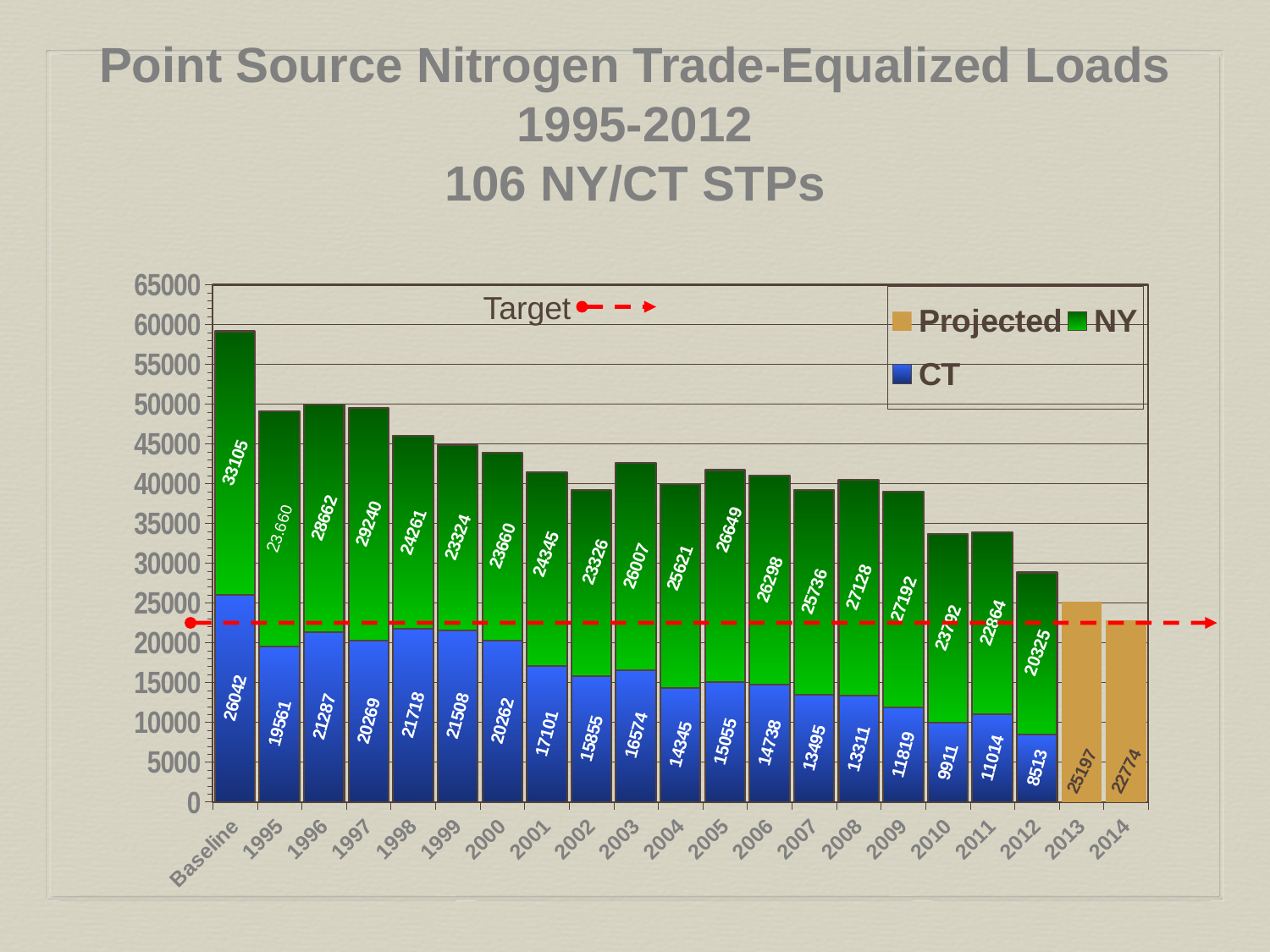
What is the difference between the NY value for 1997 and the NY value for 2012? 8915 What is the NY value for 2012? 20325 Which category has the lowest CT value? 2012 What kind of chart is shown on the slide? Stacked bar chart Which category has the highest CT value? Baseline What is the CT value for the Baseline bar? 26042 Do the CT values generally rise or fall from Baseline to 2012? Fall What is the total of the stacked bar for 2012 (CT plus NY)? 28838 Is the total height of the Baseline bar greater or less than 55000? greater What is the Projected value for 2014? 22774 How many series does the legend list? 3 Which is larger, the CT value for 2010 or the CT value for 2011? 2011